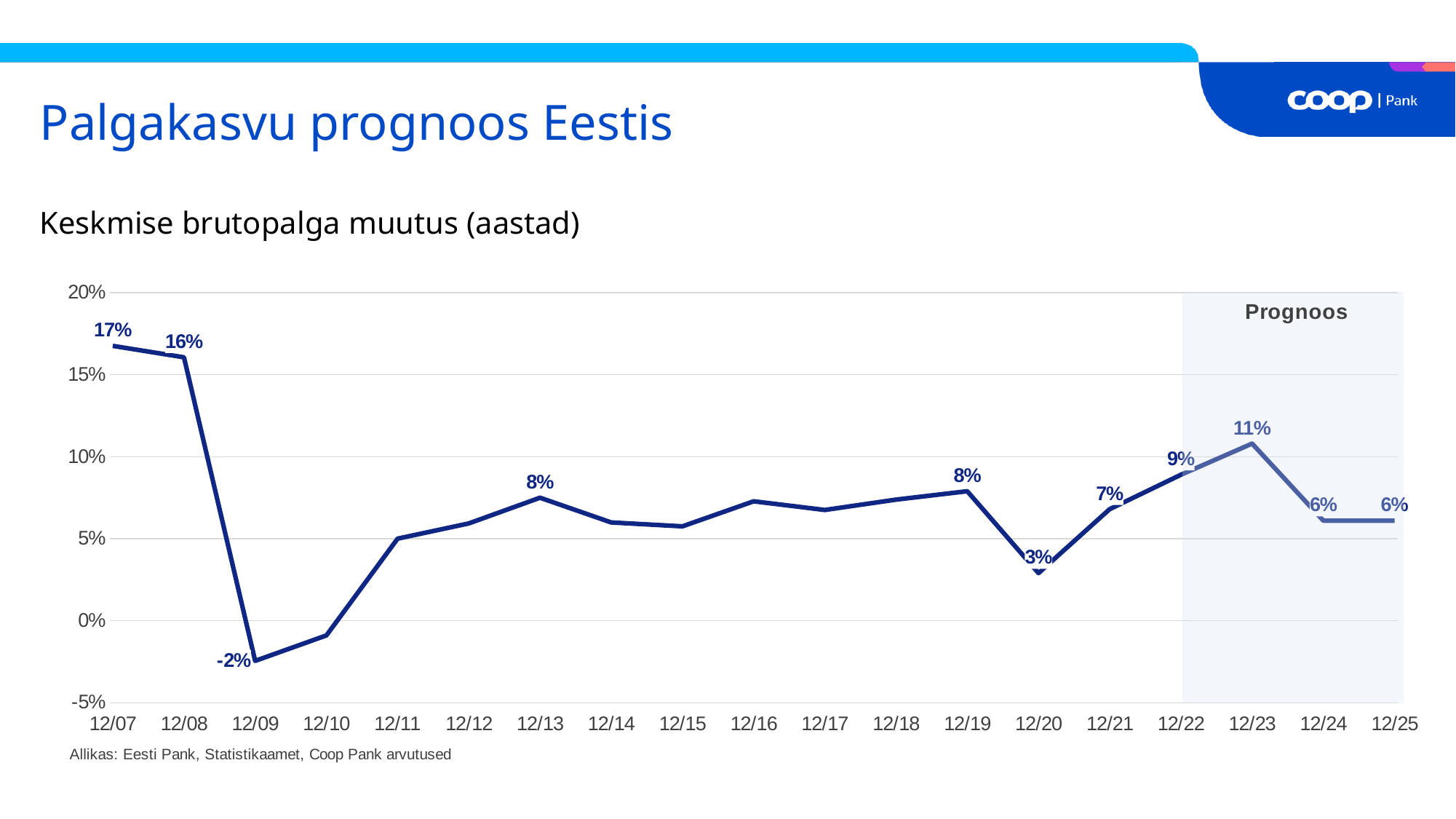
What is the value for 12/09? -2% What is the value for 12/23? 11% Which is larger, the value for 12/21 or the value for 12/22? 12/22 What is the value for 12/20? 3% What kind of chart is shown? line chart What is the value for 12/07? 17% What label is shown in the shaded area on the right of the chart? Prognoos Is the value for 12/10 greater or less than 0%? less Which year has the highest value? 12/07 Which year has the lowest value? 12/09 How many points are plotted on the x axis? 19 What is the difference between the values for 12/23 and 12/24? 5 percentage points